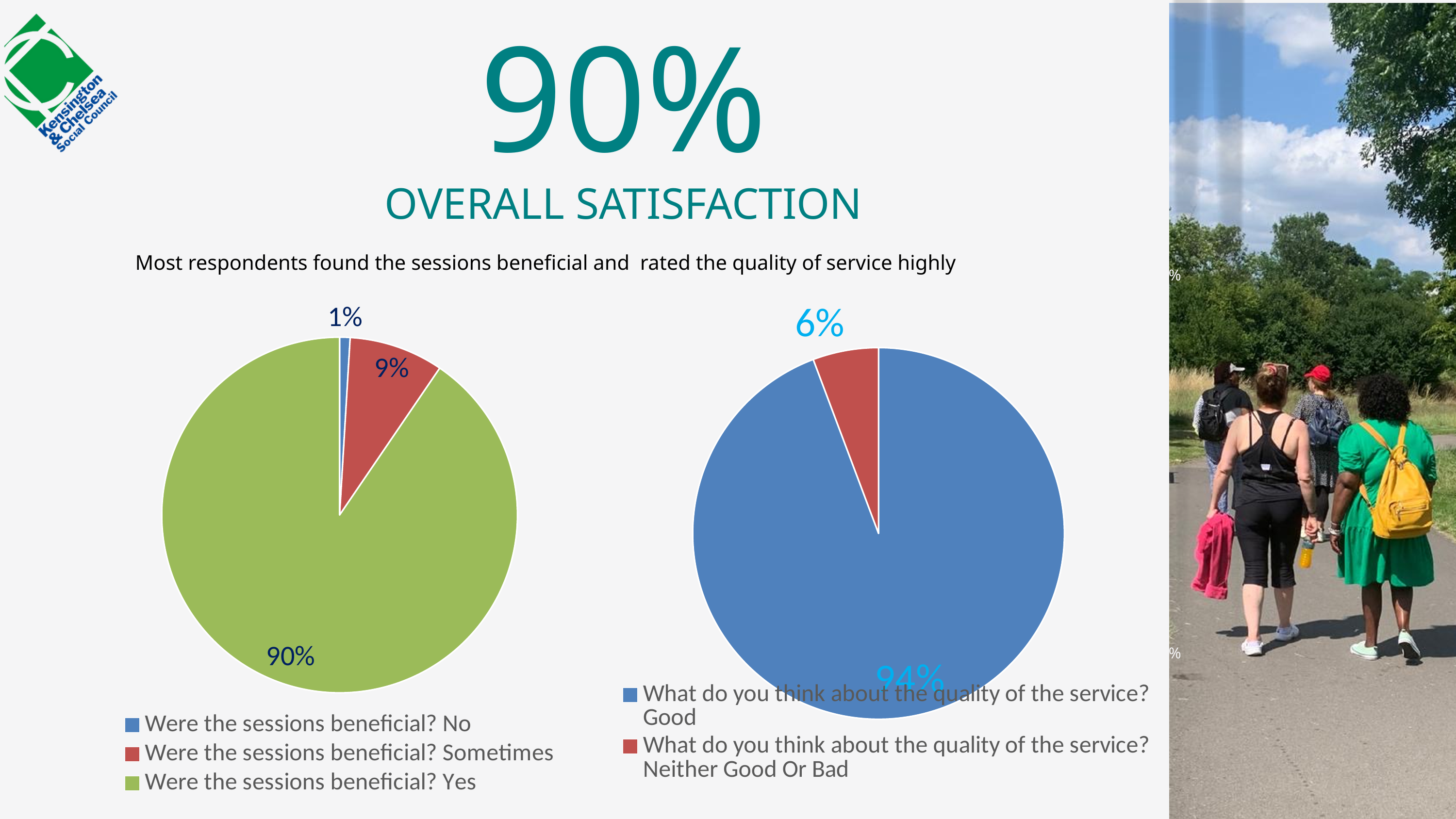
In the left pie chart, what is the difference in percentage points between the 'Sometimes' and 'No' slices? 8 In the right pie chart, what share of respondents rated the quality of the service 'Good'? 94% In the left pie chart, what share of respondents answered 'Yes' to 'Were the sessions beneficial?' 90% In the left pie chart, what share of respondents answered 'No' to 'Were the sessions beneficial?' 1% In the left pie chart, which response has the smallest slice? No What type of chart is used on the left of the slide? Pie chart In the left pie chart, what share of respondents answered 'Sometimes' to 'Were the sessions beneficial?' 9% How many slices does the left pie chart have? 3 In the right pie chart, what share of respondents rated the quality of the service 'Neither Good Or Bad'? 6% In the left pie chart, which response has the largest slice? Yes In the right pie chart, what is the difference in percentage points between the 'Good' and 'Neither Good Or Bad' slices? 88 How many entries does the legend of the right pie chart list? 2